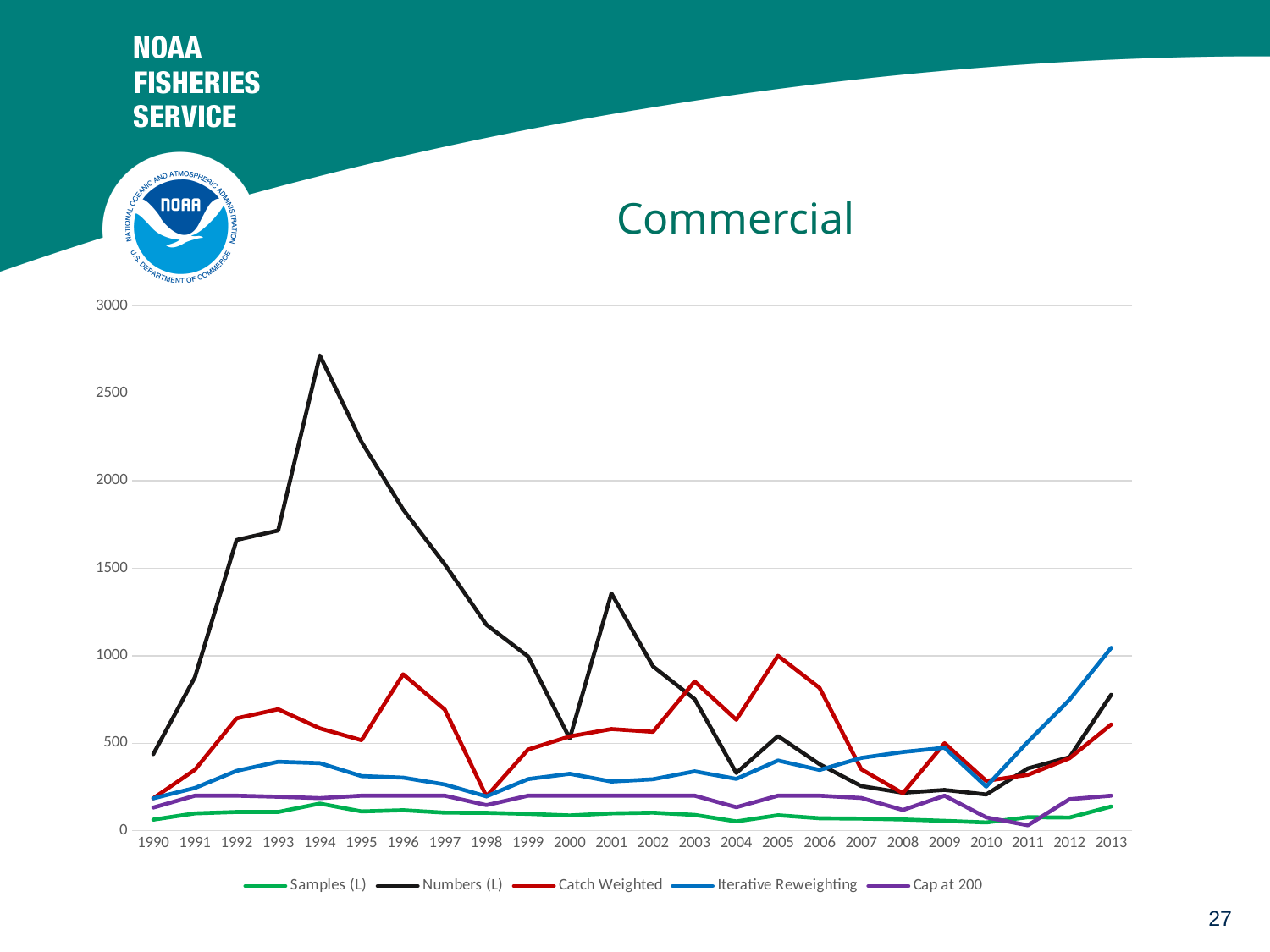
In 1994, which is larger: Numbers (L) or Catch Weighted? Numbers (L) How many series does the legend list? 5 Is the value for Numbers (L) in 1994 greater or less than 2500? greater What is the title of the chart? Commercial Does the Numbers (L) series rise or fall from 1994 to 2000? Fall In 2013, which is larger: Iterative Reweighting or Numbers (L)? Iterative Reweighting Is the value for Cap at 200 in 1993 greater or less than 500? less Is the value for Catch Weighted in 1996 greater or less than 1000? less How many years are plotted along the x axis? 24 What kind of chart is shown on the slide? Line chart In which year does the Numbers (L) series reach its highest value? 1994